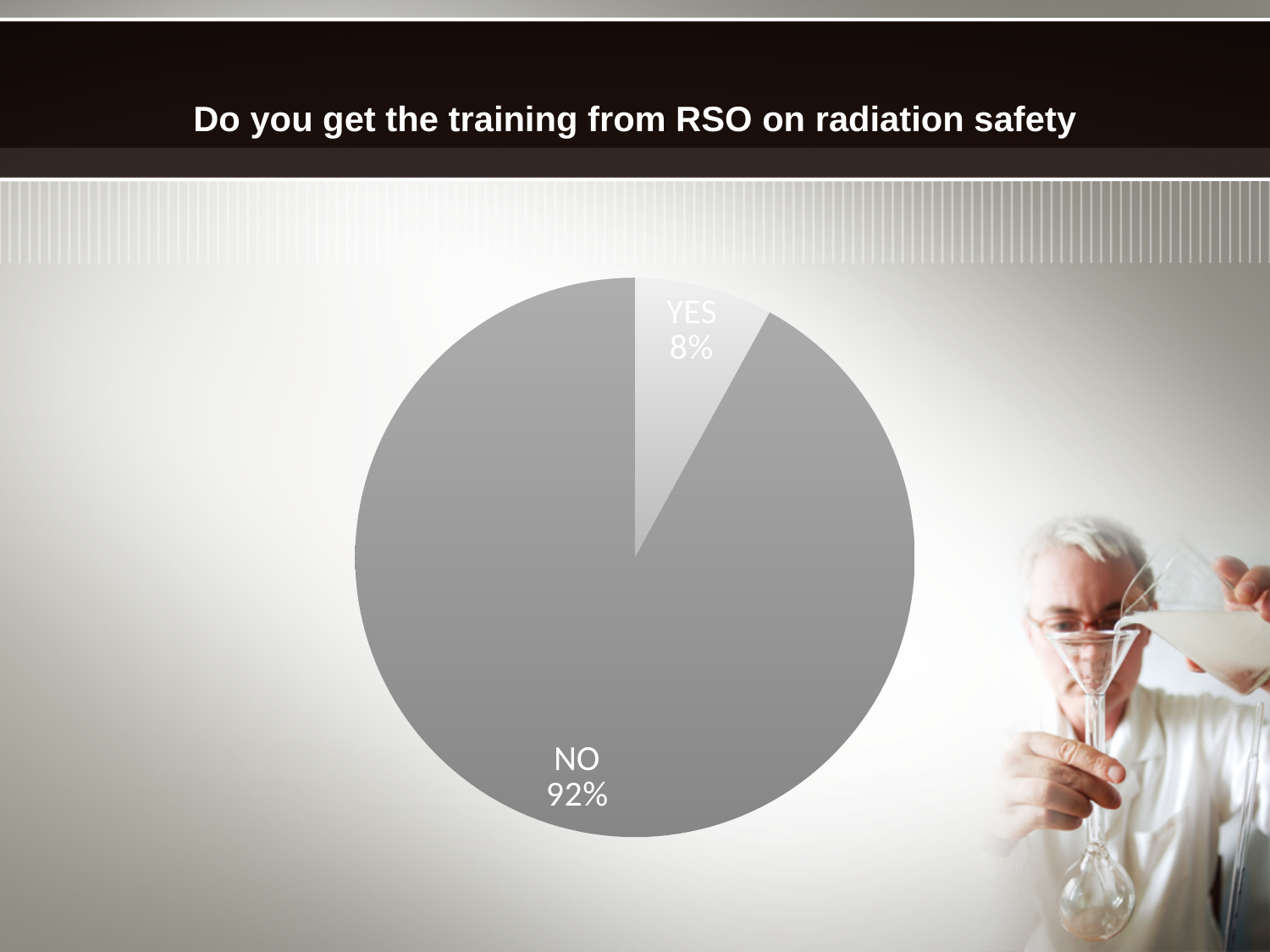
Which response has the smallest share of the pie? YES Which slice is shown in the lighter shade of grey? YES What kind of chart is shown on the slide? Pie chart What is the title of the slide containing the chart? Do you get the training from RSO on radiation safety What percentage of respondents answered NO? 92% How many slices does the pie chart have? 2 What share of the pie does the YES slice represent? 8% What percentage of respondents answered YES? 8% Which slice is larger, YES or NO? NO Which response has the largest share of the pie? NO What is the difference in percentage points between the NO and YES slices? 84